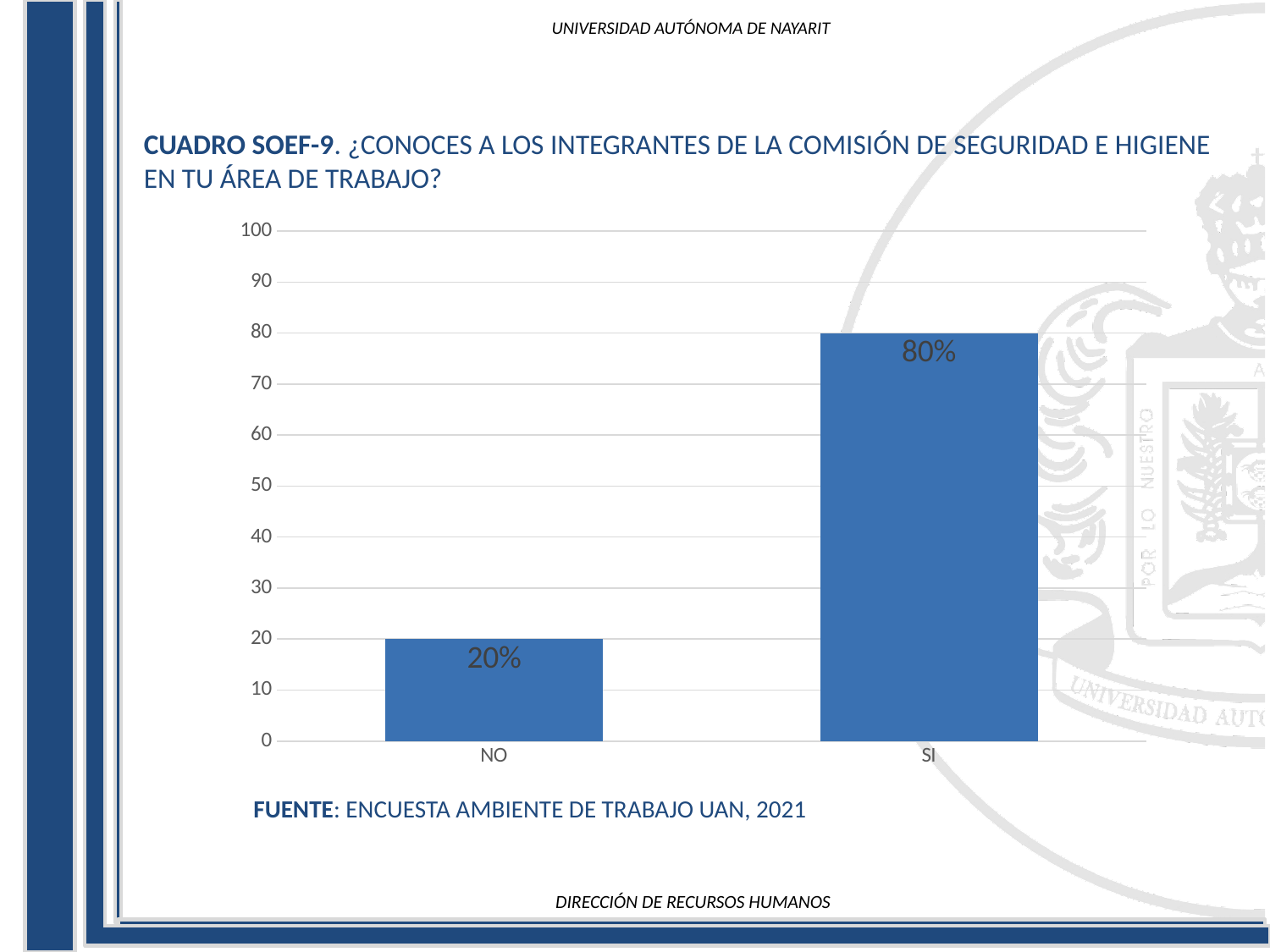
What source is cited below the chart? ENCUESTA AMBIENTE DE TRABAJO UAN, 2021 What is the difference between the values for SI and NO? 60% Which category has the highest value? SI What kind of chart is shown on the slide? bar chart What is the highest value shown on the vertical axis? 100 How many categories are shown on the x axis? 2 Which is larger, the value for NO or the value for SI? SI What is the value for NO? 20% Is the value for SI greater or less than 50? greater Which category has the lowest value? NO What is the value for SI? 80% Is the value for NO greater or less than 30? less